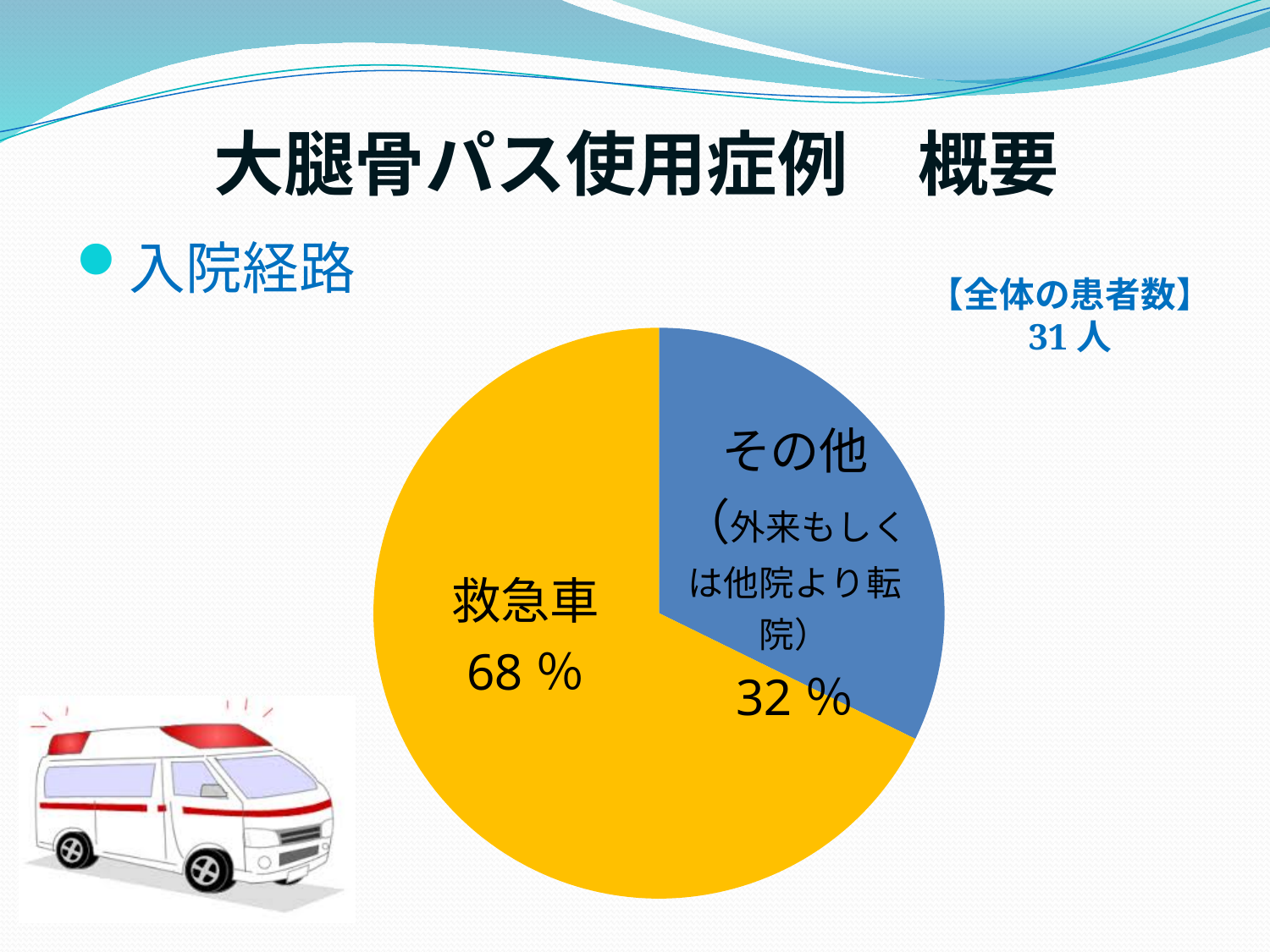
What share of the pie chart is labelled その他 (外来もしくは他院より転院)? 32 % What is the total number of patients (全体の患者数) stated next to the pie chart? 31 人 What kind of chart is shown on the slide? pie chart Which slice of the pie chart is the largest? 救急車 How many slices does the pie chart have? 2 Is the share for 救急車 greater or less than 50%? greater What is the difference in percentage points between the 救急車 slice and the その他 slice? 36 Which is larger, the 救急車 slice or the その他 slice? 救急車 What share of the pie chart is labelled 救急車? 68 % Which slice of the pie chart is the smallest? その他 What colour is the 救急車 slice of the pie chart? yellow